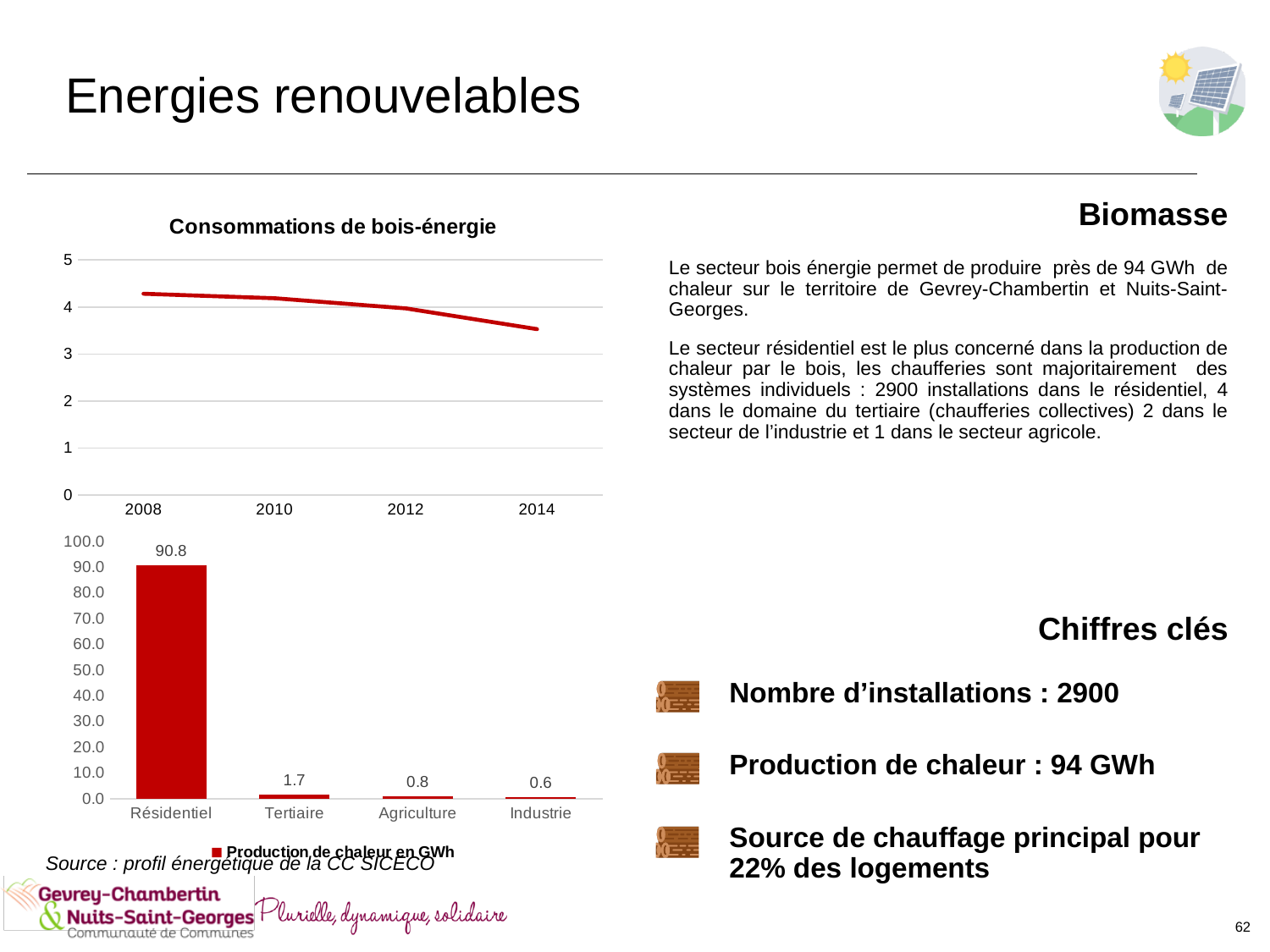
In the bottom bar chart, what is the value for Industrie? 0.6 In the bottom bar chart, what is the value for Tertiaire? 1.7 What kind of chart is the chart titled 'Consommations de bois-énergie'? line chart In the chart titled 'Consommations de bois-énergie', do the values rise or fall from 2008 to 2014? fall In the bottom bar chart, what is the value for Résidentiel? 90.8 In the bottom bar chart, which category has the highest value? Résidentiel In the bottom bar chart, which category has the lowest value? Industrie In the bottom bar chart, how many categories are shown on the x axis? 4 In the bottom bar chart, what series name does the legend show? Production de chaleur en GWh In the bottom bar chart, what is the difference between the values for Tertiaire and Agriculture? 0.9 In the bottom bar chart, which is larger, the value for Agriculture or the value for Industrie? Agriculture In the chart titled 'Consommations de bois-énergie', is the value for 2014 greater or less than 4? less